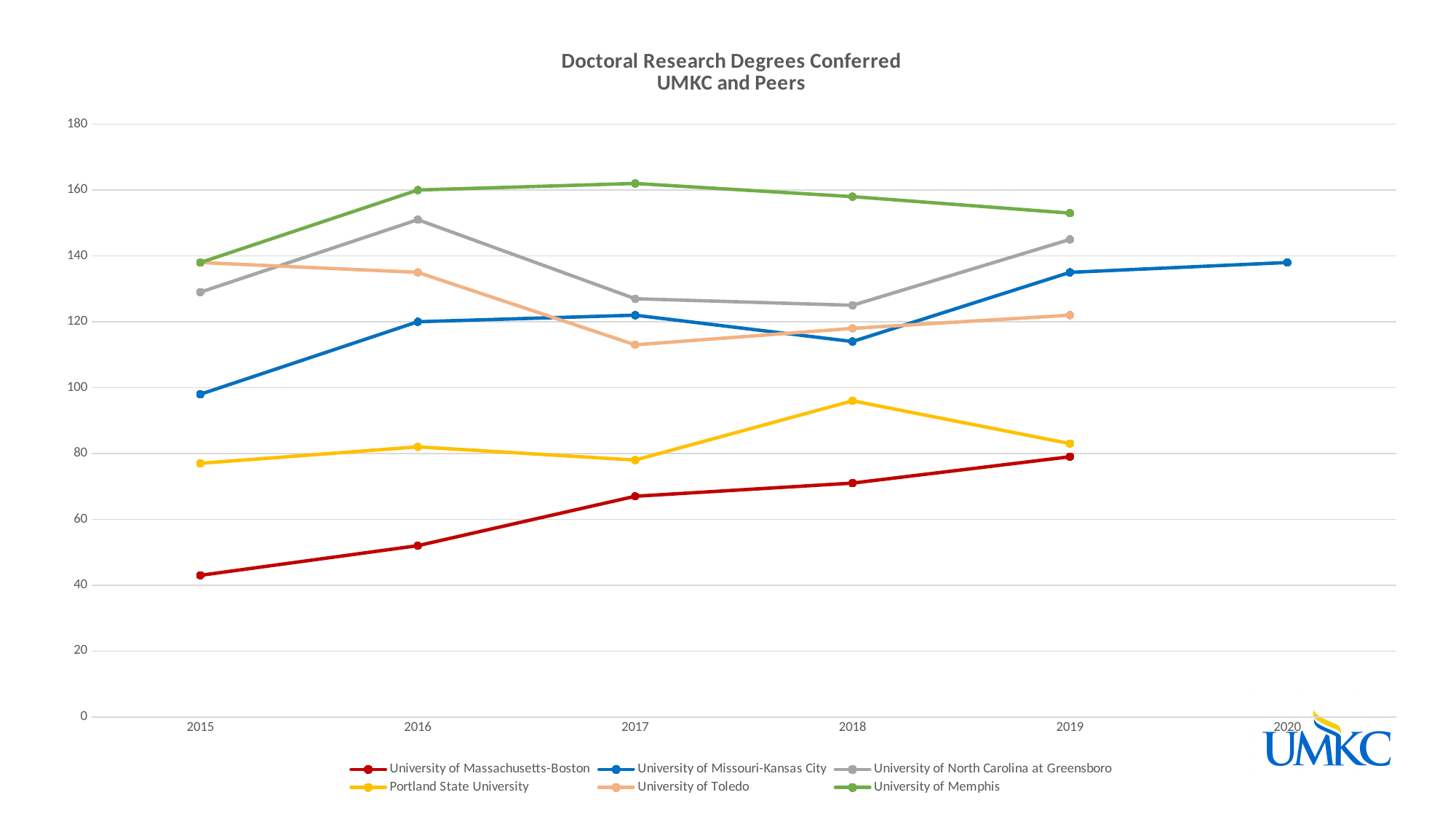
How many years are shown on the x axis? 6 Is the value for University of Memphis in 2016 greater or less than 140? greater Which university had the highest number of doctoral research degrees conferred in 2017? University of Memphis Is the value for University of Toledo in 2017 greater or less than 120? less Which university had the lowest number of doctoral research degrees conferred in 2015? University of Massachusetts-Boston What kind of chart is shown on the slide? line chart How many series does the legend list? 6 Do the values for University of Massachusetts-Boston rise or fall from 2015 to 2019? rise Which series is the only one with a data point plotted for 2020? University of Missouri-Kansas City In 2016, which is larger: the value for University of North Carolina at Greensboro or the value for University of Toledo? University of North Carolina at Greensboro In which year does the University of Missouri-Kansas City line reach its highest value? 2020 Is the value for University of Missouri-Kansas City in 2015 greater or less than 100? less